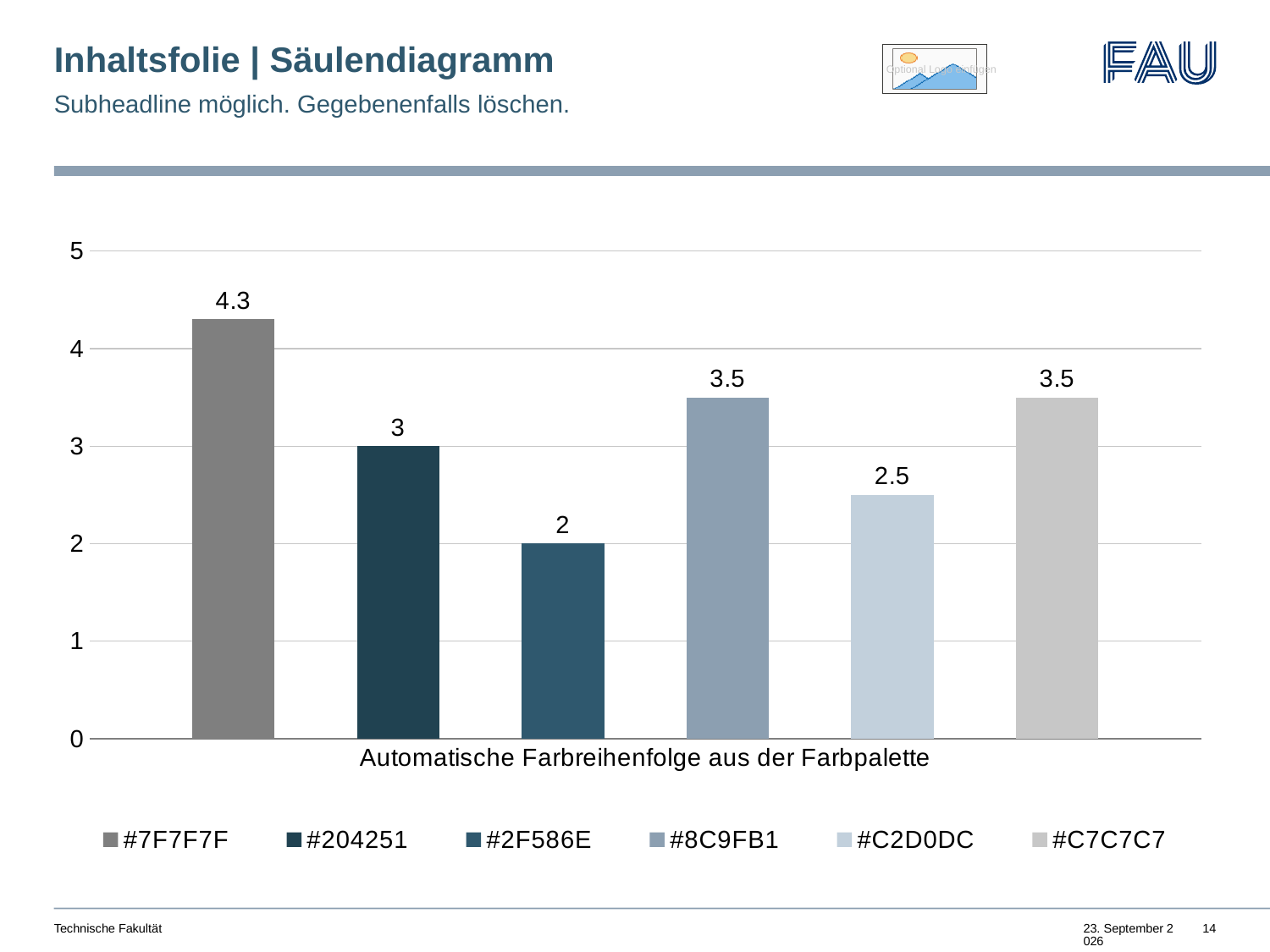
What is the value for the series #7F7F7F? 4.3 What is the value for the series #8C9FB1? 3.5 What is the difference between the values for #7F7F7F and #2F586E? 2.3 What kind of chart is shown on the slide? Bar chart Which is larger, the value for #204251 or the value for #8C9FB1? #8C9FB1 What is the category label shown on the x axis? Automatische Farbreihenfolge aus der Farbpalette What is the value for the series #204251? 3 Which series has the lowest value? #2F586E What is the difference between the values for #204251 and #C2D0DC? 0.5 What is the value for the series #C2D0DC? 2.5 Which series has the highest value? #7F7F7F How many series does the legend list? 6